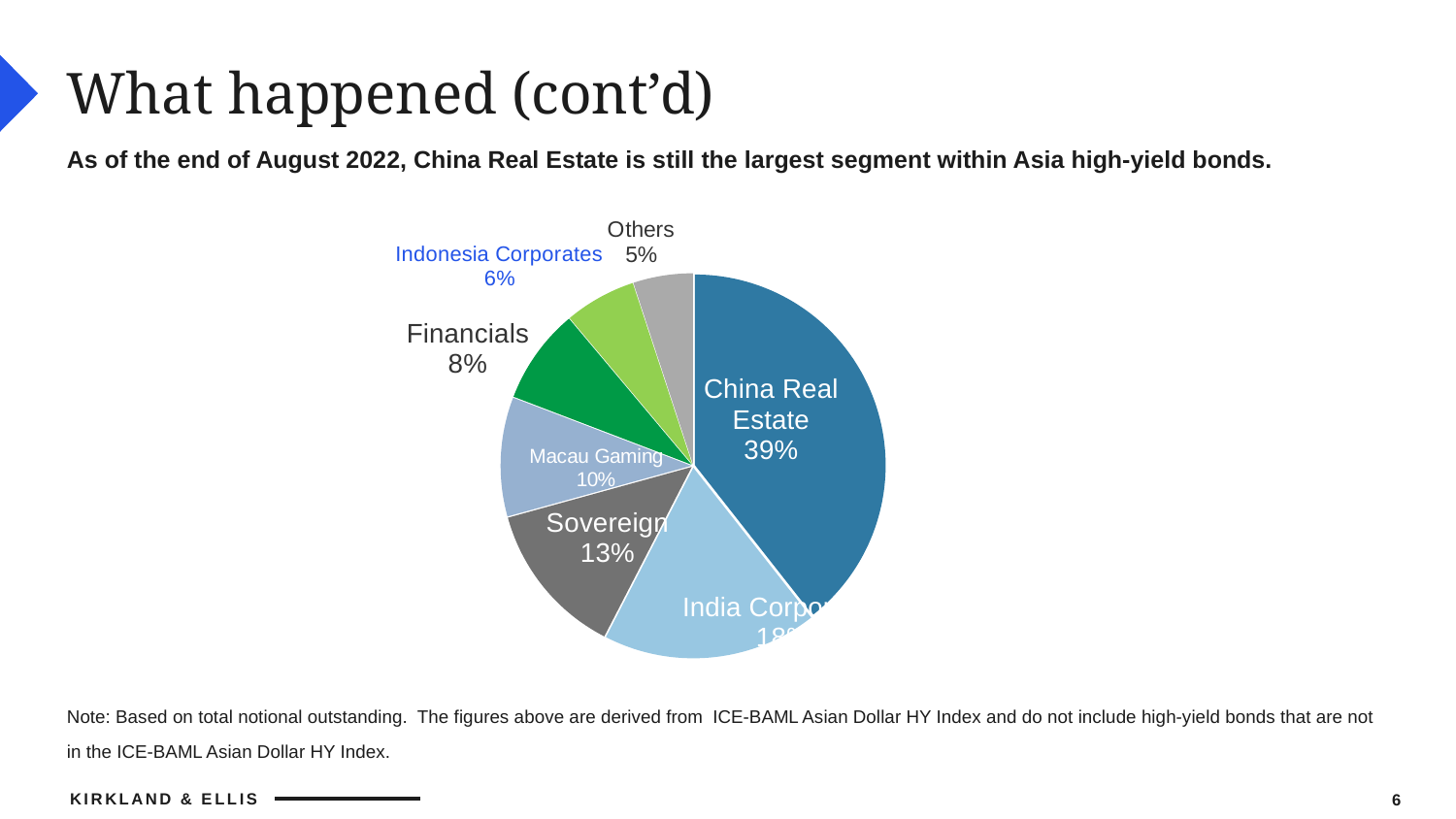
What percentage is shown for Indonesia Corporates? 6% Which segment is the smallest in the pie chart? Others How many percentage points larger is China Real Estate than Sovereign? 26 percentage points Which is larger, Financials or Macau Gaming? Macau Gaming What percentage is shown for Macau Gaming? 10% How many segments does the pie chart have? 7 Which segment is the largest in the pie chart? China Real Estate What share of Asia high-yield bonds does China Real Estate represent in the pie chart? 39% What percentage is shown for the Sovereign segment? 13% What percentage is shown for Financials? 8% What kind of chart is shown on the slide? Pie chart What percentage is shown for the Others segment? 5%